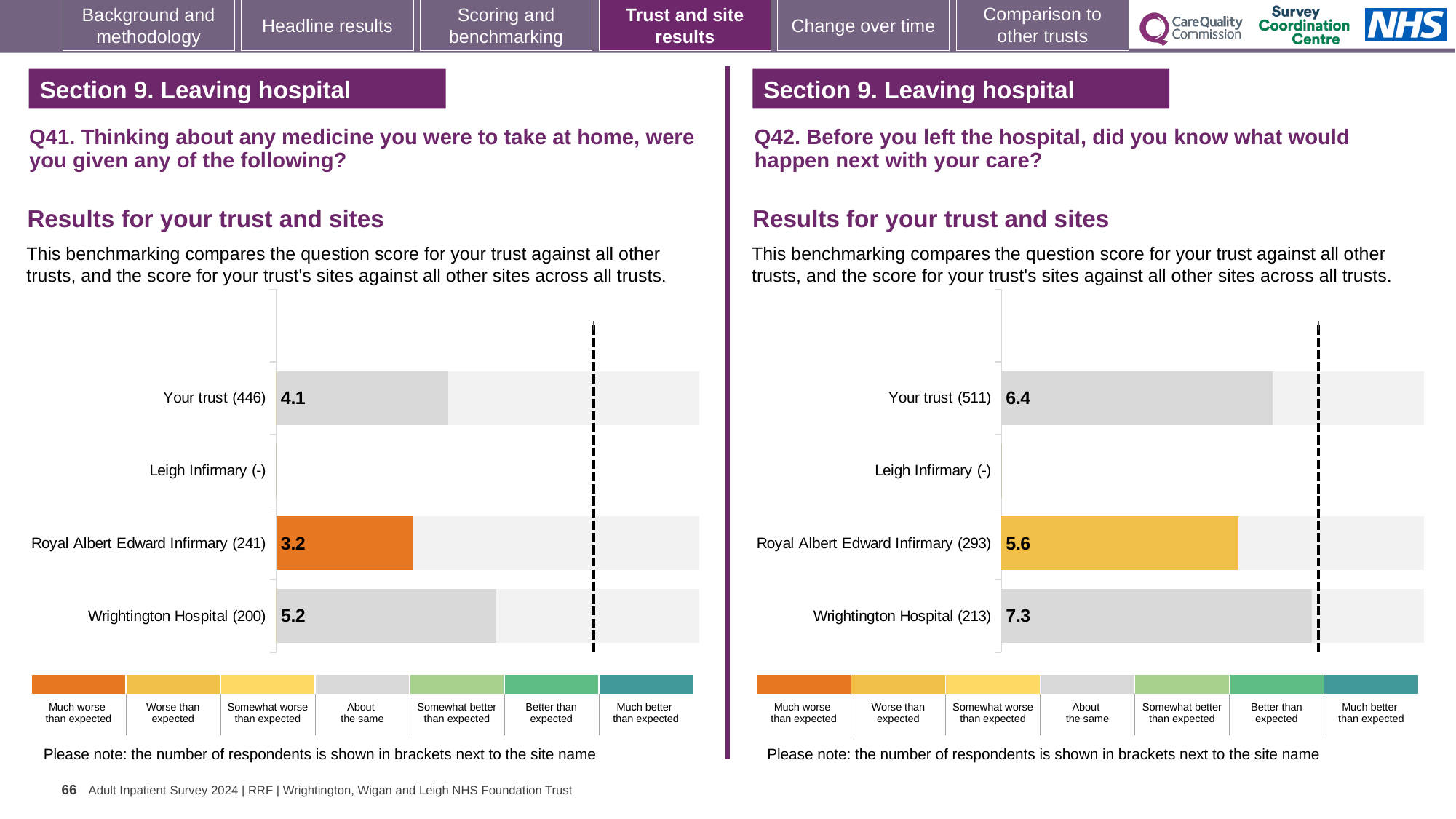
In the Q41 chart on the left, what is the score for Royal Albert Edward Infirmary? 3.2 In the Q42 chart on the right, what is the difference between the scores for Your trust and Royal Albert Edward Infirmary? 0.8 In the Q41 chart on the left, what is the difference between the scores for Wrightington Hospital and Royal Albert Edward Infirmary? 2.0 In the Q42 chart on the right, is the score for Wrightington Hospital larger or smaller than the score for Your trust? Larger In the Q41 chart on the left, which site has the highest score? Wrightington Hospital In the Q41 chart on the left, what colour is the bar for Royal Albert Edward Infirmary? Orange What type of chart is used in the Q41 chart on the left? Bar chart In the Q41 chart on the left, what is the score for Your trust? 4.1 How many respondents are shown in brackets for Your trust in the Q42 chart on the right? 511 In the Q42 chart on the right, what is the score for Wrightington Hospital? 7.3 In the Q42 chart on the right, what is the score for Your trust? 6.4 In the Q42 chart on the right, which site has the lowest score among those with a value shown? Royal Albert Edward Infirmary